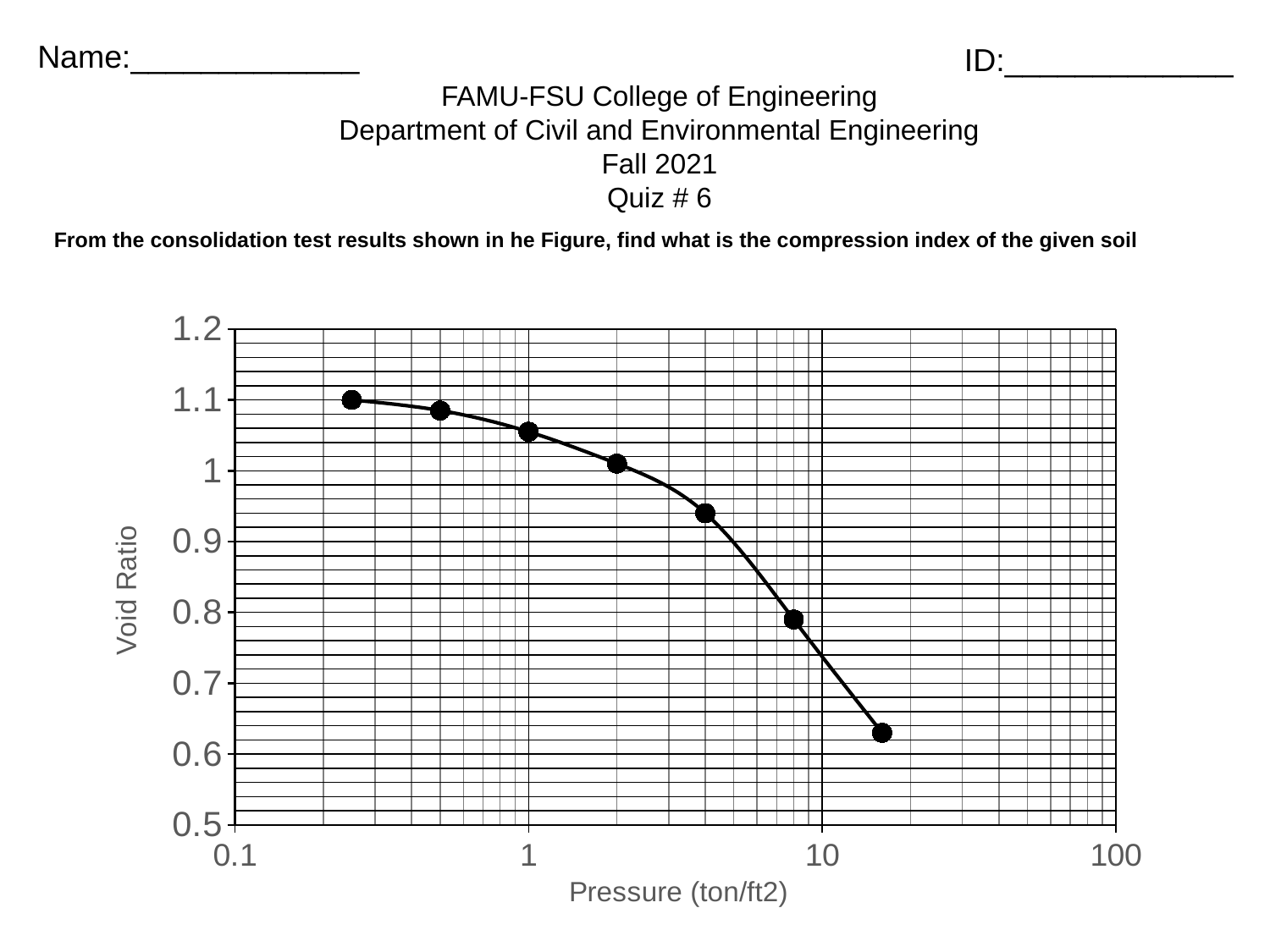
What kind of chart is shown on the slide? line chart Does the void ratio rise or fall as pressure increases along the x axis? fall How many data points are plotted on the chart? 7 Is the void ratio of the rightmost data point greater or less than 0.6? greater What is the label of the x axis? Pressure (ton/ft2) Is the void ratio at a pressure of 1 ton/ft2 greater or less than 1.0? greater Is the void ratio of the rightmost data point greater or less than 0.7? less What is the label of the y axis? Void Ratio Which data point has the highest void ratio, the leftmost or the rightmost? leftmost